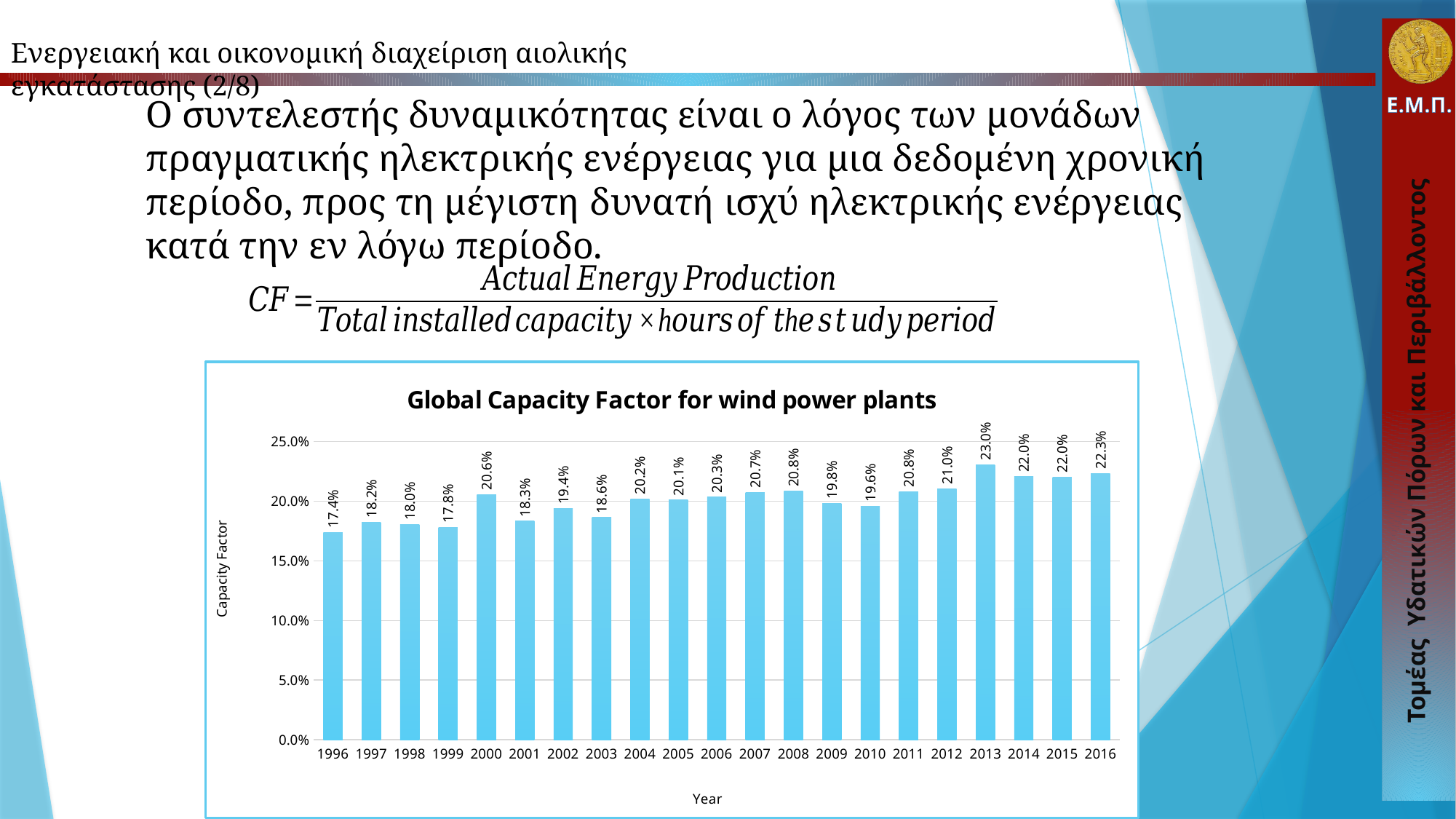
What is the title of the chart? Global Capacity Factor for wind power plants How many years are shown on the x axis of the chart? 21 What is the difference between the capacity factor in 2013 and in 1996? 5.6 percentage points What is the capacity factor shown for 2008? 20.8% Overall, does the capacity factor rise or fall from 1996 to 2016? Rise Is the value for 2012 greater or less than 20.0%? greater Which year has the highest capacity factor? 2013 Which year has the lowest capacity factor? 1996 Which year has a higher capacity factor, 2000 or 2001? 2000 What is the capacity factor shown for 2013? 23.0% What is the capacity factor shown for 1996? 17.4% What kind of chart is shown on the slide? Bar chart